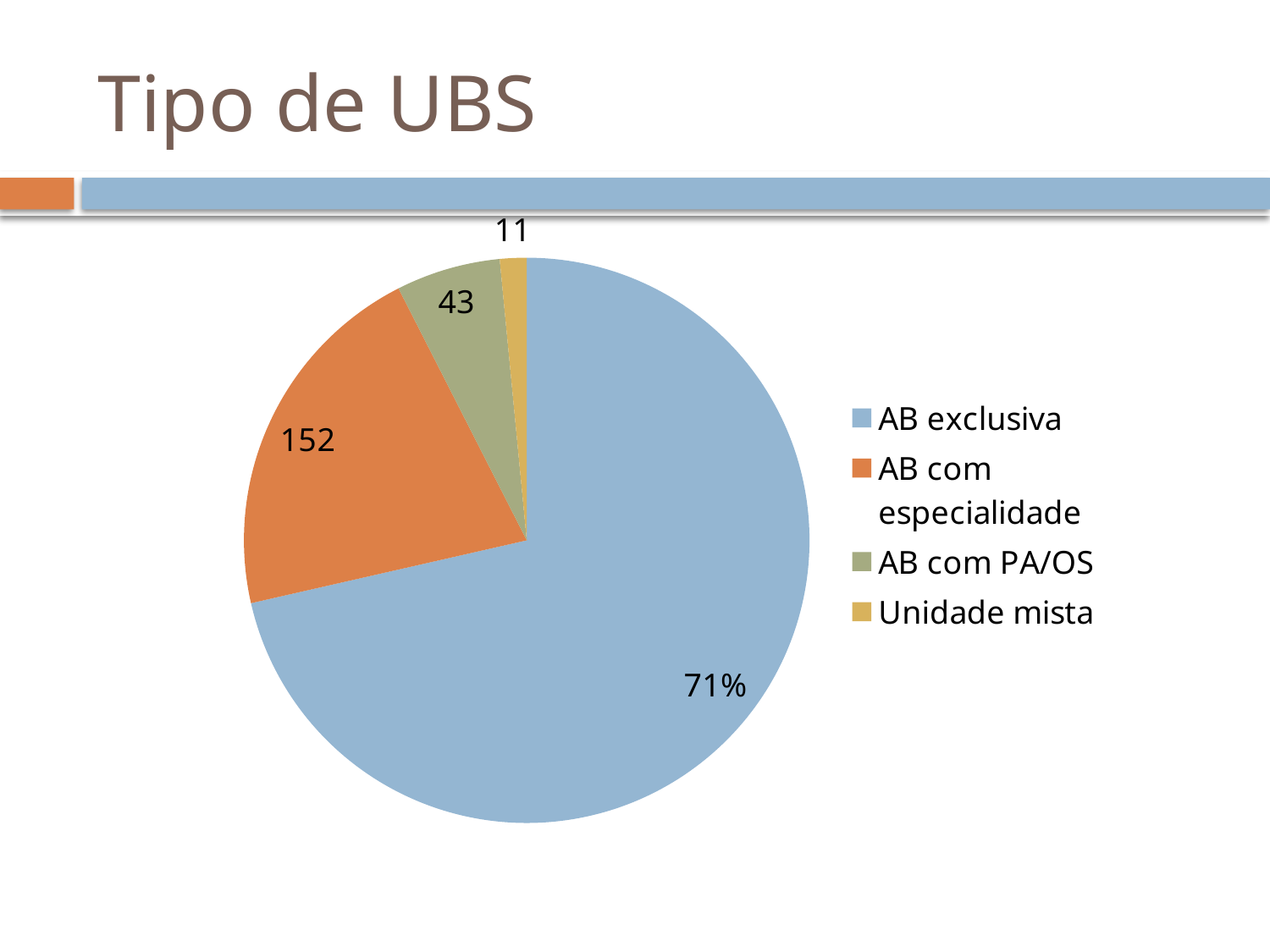
Which slice is larger, AB com PA/OS or Unidade mista? AB com PA/OS What value is labelled on the AB com especialidade slice? 152 How many slices does the pie chart have? 4 What kind of chart is shown on the slide? pie chart What is the title of the slide? Tipo de UBS What share of the pie does AB exclusiva represent? 71% What is the difference between the labelled values for AB com especialidade and AB com PA/OS? 109 Which category has the largest slice of the pie? AB exclusiva How many entries does the legend list? 4 What value is labelled on the Unidade mista slice? 11 Which category has the smallest slice of the pie? Unidade mista What value is labelled on the AB com PA/OS slice? 43